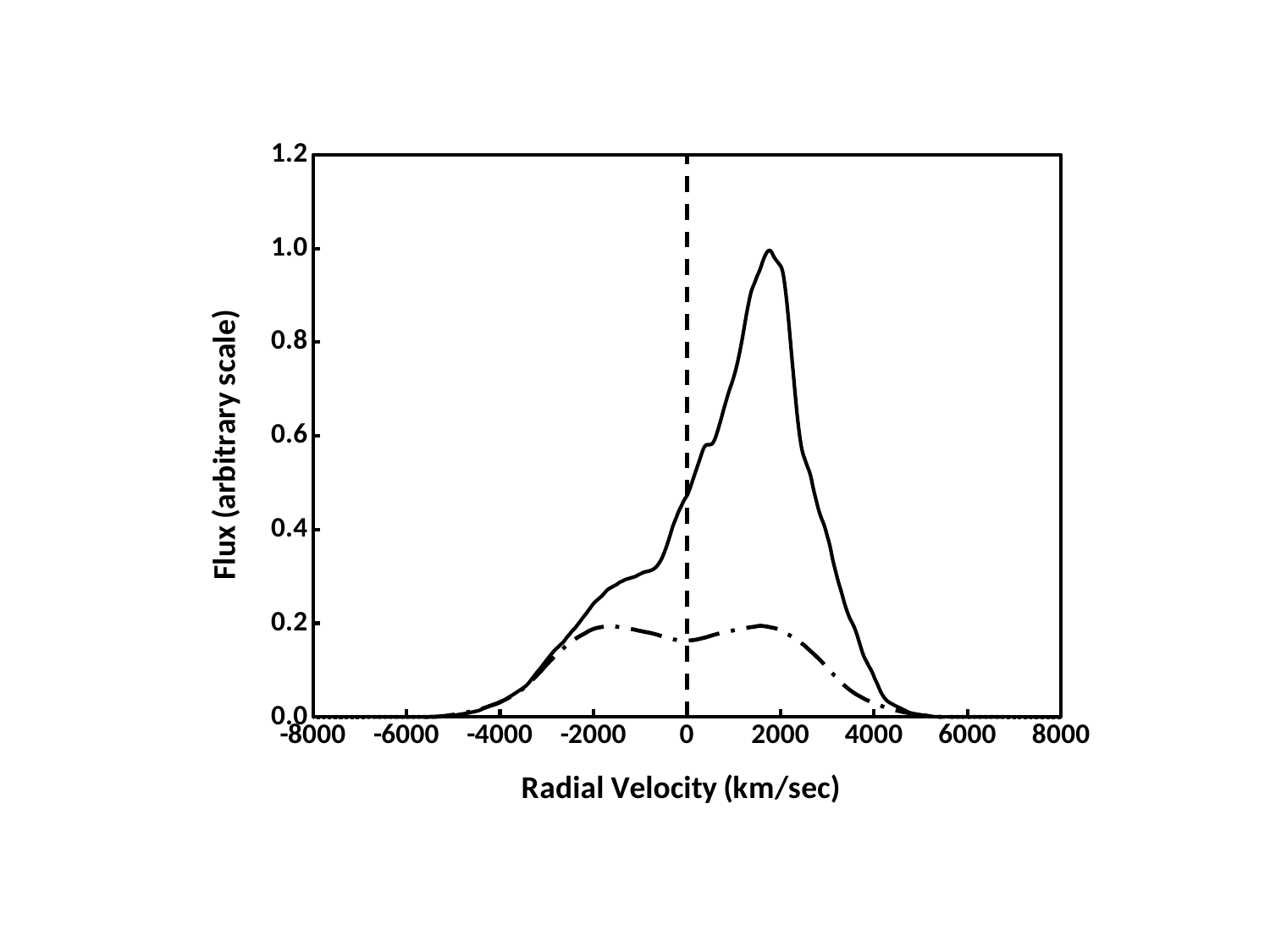
Which line reaches the higher peak flux, the solid line or the dash-dot line? the solid line How many data curves are plotted, not counting the vertical dashed reference line? 2 Is the value of the solid line at a radial velocity of 0 km/sec greater or less than 0.6? less What is the label of the x axis? Radial Velocity (km/sec) At a radial velocity of 2000 km/sec, which line has the higher flux, the solid line or the dash-dot line? the solid line Is the value of the solid line at a radial velocity of 4000 km/sec greater or less than 0.2? less At what radial velocity is the vertical dashed reference line drawn? 0 What kind of chart is shown on the slide? line chart Is the peak value of the dash-dot line greater or less than 0.4? less What is the label of the y axis? Flux (arbitrary scale) Does the solid line rise or fall as radial velocity increases from 2000 to 4000 km/sec? fall